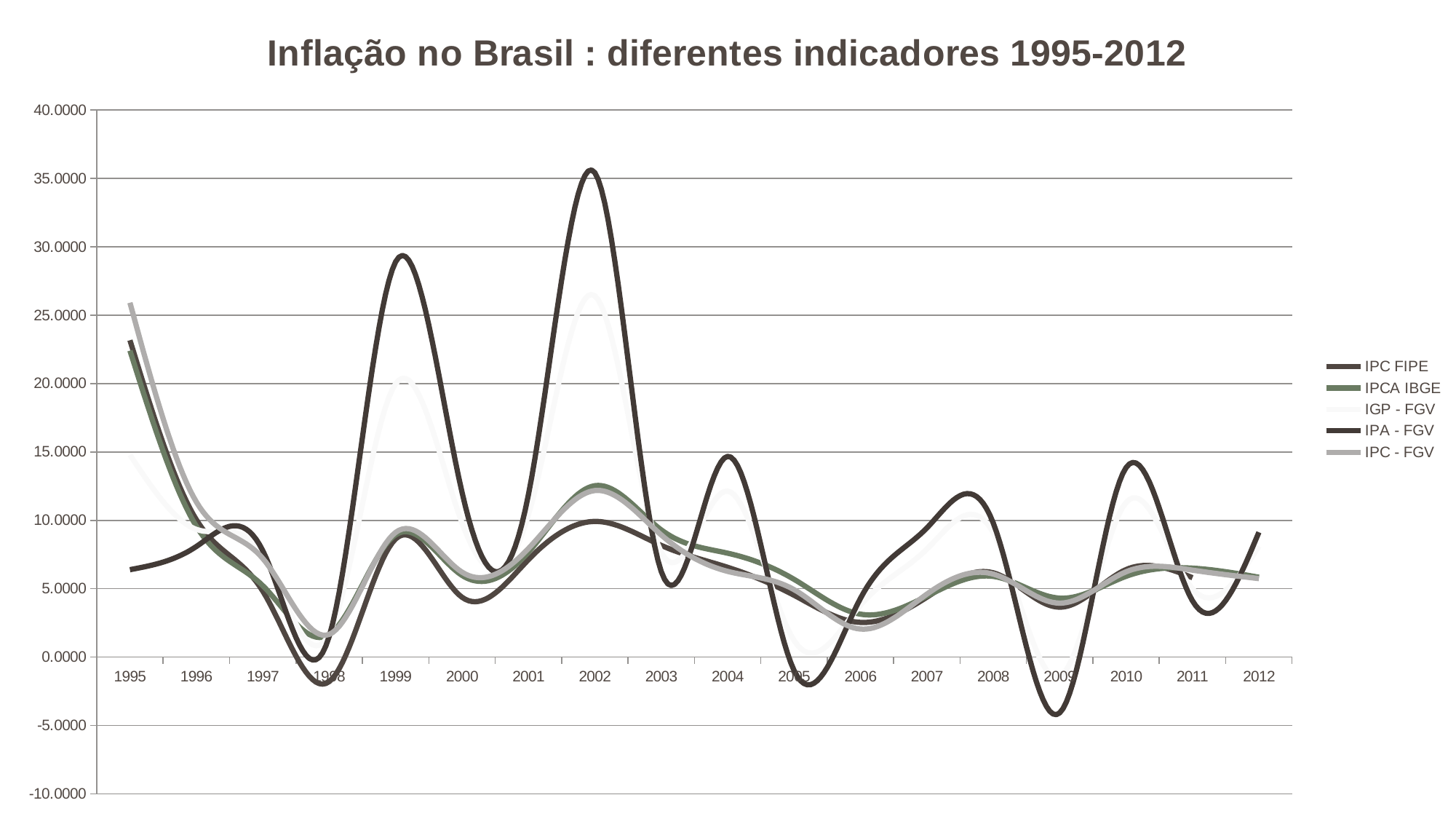
Is the value for IPCA IBGE in 2002 greater or less than 10? greater How many years are plotted along the x axis? 18 Does the IPCA IBGE series rise or fall from 1995 to 1998? fall How many series does the legend list? 5 In which year does the IPCA IBGE series reach its lowest value? 1998 Is the value for IGP - FGV in 2002 greater or less than 20? greater In which year does the IPCA IBGE series reach its highest value? 1995 What is the title of the chart? Inflação no Brasil : diferentes indicadores 1995-2012 Which series is drawn in green? IPCA IBGE Is the value for IPC - FGV in 1995 greater or less than 20? greater What kind of chart is shown on the slide? line chart